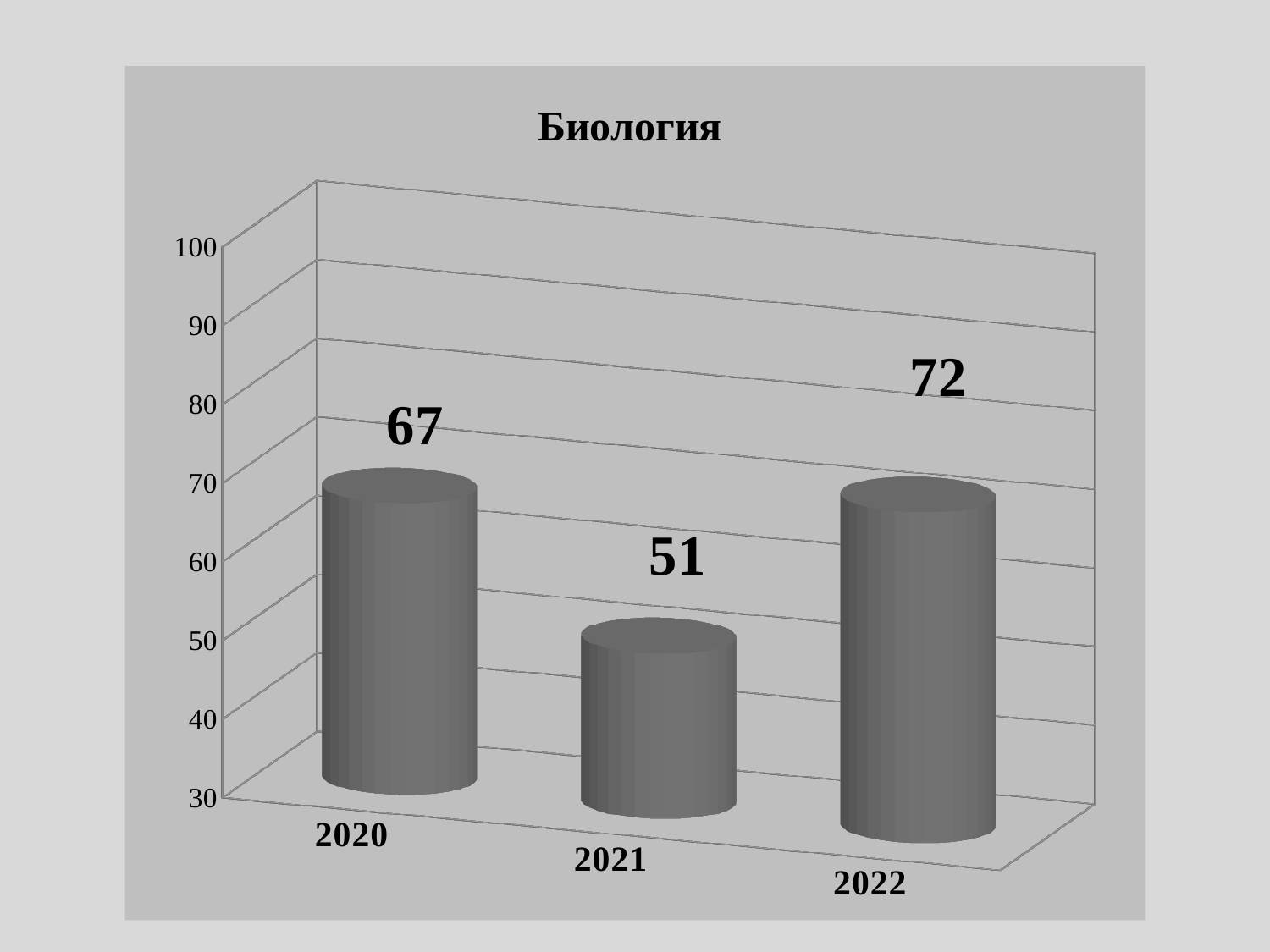
What is the value for 2022? 72 What is the difference between the values for 2020 and 2021? 16 Which year has the highest value? 2022 How many years are shown on the chart? 3 Which year has the lowest value? 2021 Which is larger, the value for 2020 or the value for 2022? 2022 What is the value for 2020? 67 What is the difference between the values for 2022 and 2021? 21 What kind of chart is shown on the slide? bar chart What is the title of the chart? Биология What is the value for 2021? 51 Is the value for 2021 greater or less than 60? less